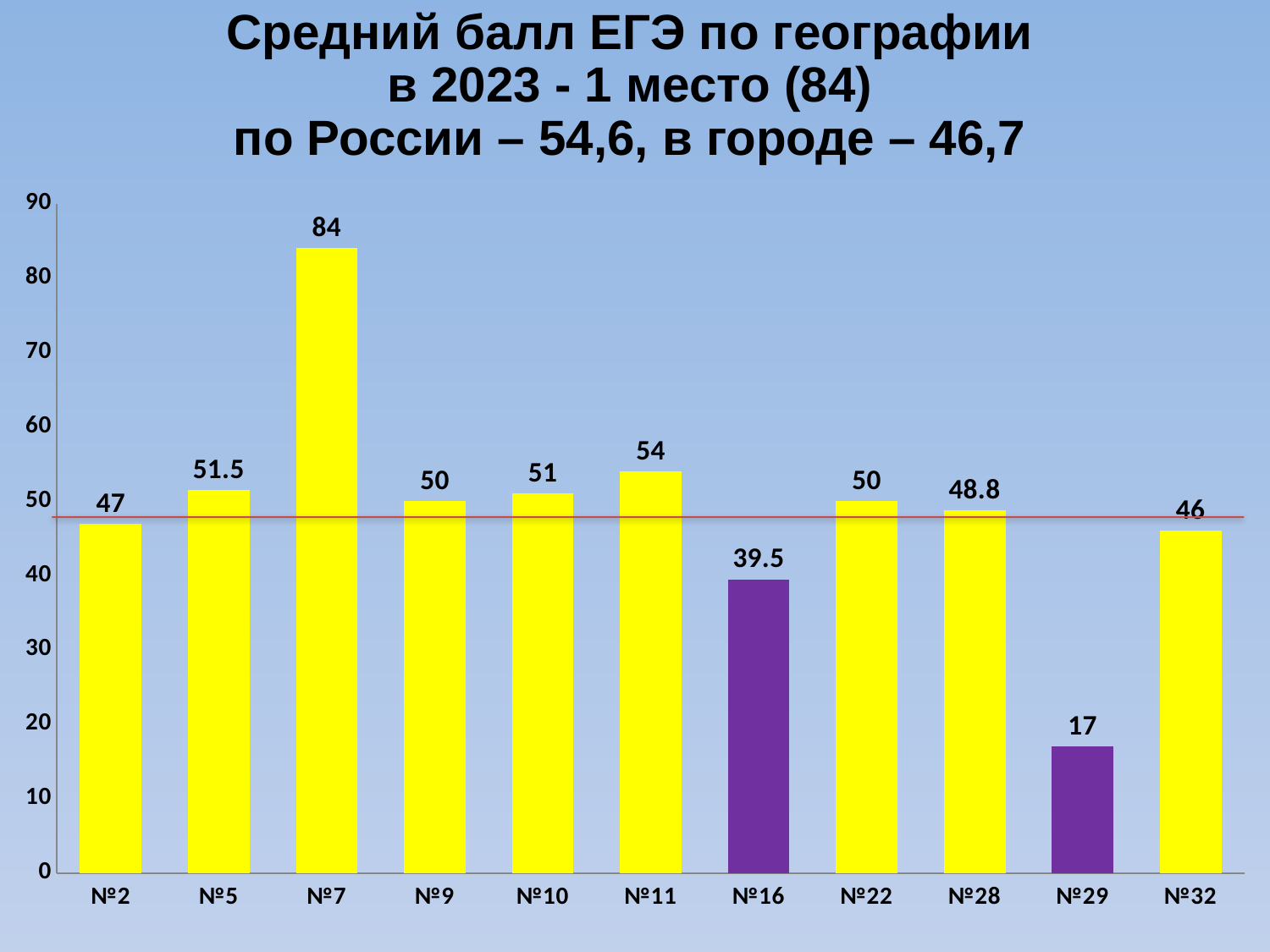
Which category has the lowest value? №29 What kind of chart is shown on the slide? bar chart What is the difference between the values for №7 and №29? 67 Which bars are coloured purple instead of yellow? №16 and №29 What is the value for №7? 84 Which category has the highest value? №7 How many categories are shown on the x axis? 11 Is the value for №16 greater or less than 40? less What is the value for №28? 48.8 What is the value for №16? 39.5 What is the difference between the values for №5 and №2? 4.5 Which is larger, the value for №11 or the value for №32? №11